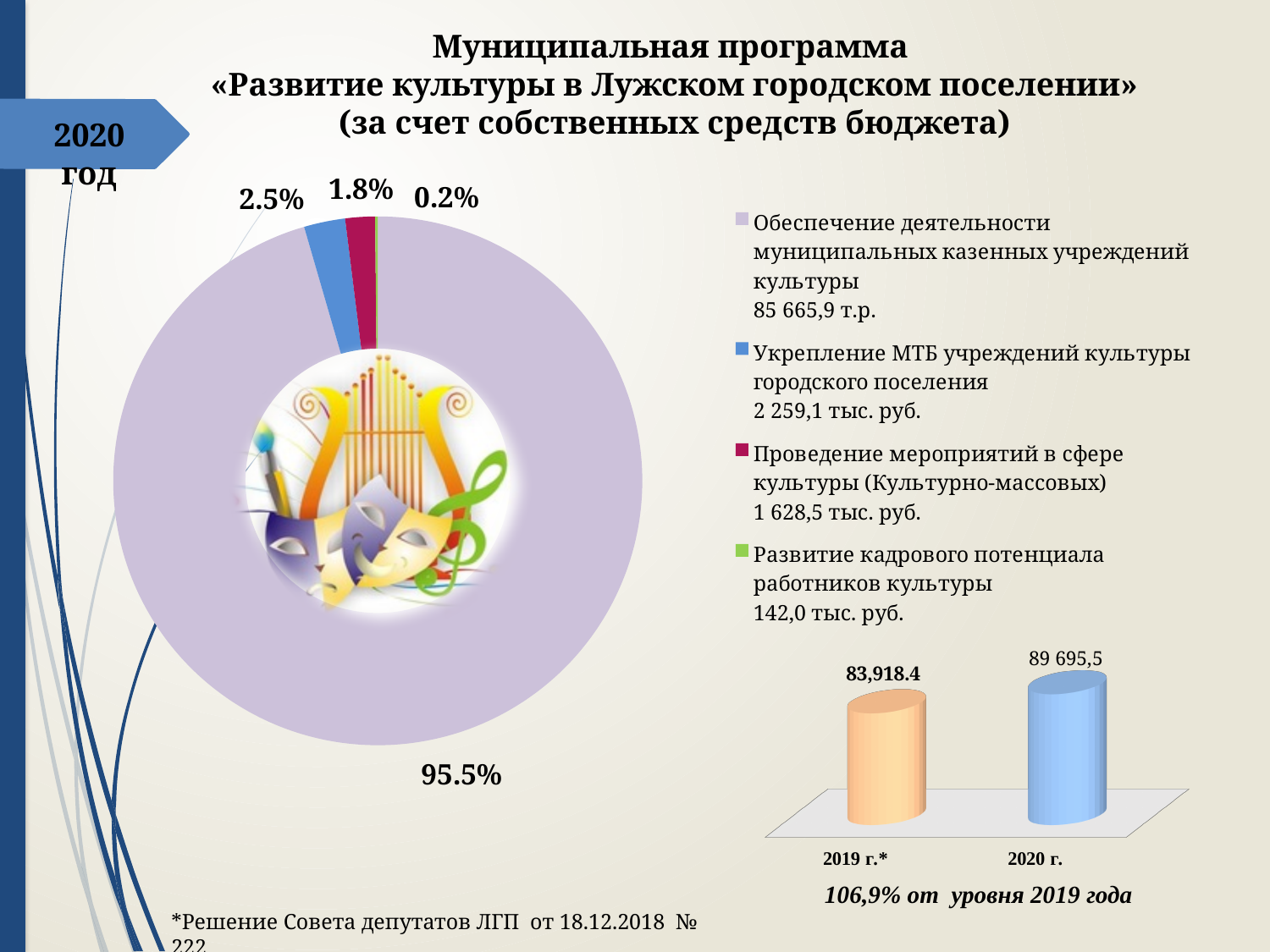
On the bar chart in the bottom right, what is the value for 2020 г.? 89 695,5 On the pie chart, what is the difference in percentage points between the 2.5% slice and the 1.8% slice? 0.7 On the pie chart, what share does the largest slice represent? 95.5% On the bar chart in the bottom right, which year has the larger value, 2019 г.* or 2020 г.? 2020 г. How many categories does the pie chart's legend list? 4 On the bar chart in the bottom right, what is the value for 2019 г.*? 83,918.4 What type of chart is shown in the bottom right of the slide? Bar chart On the pie chart, what percentage is shown for the blue slice (Укрепление МТБ учреждений культуры городского поселения)? 2.5% On the pie chart, which category has the smallest share? Развитие кадрового потенциала работников культуры On the pie chart, what percentage is shown for Проведение мероприятий в сфере культуры (Культурно-массовых)? 1.8% On the pie chart, which category has the largest share? Обеспечение деятельности муниципальных казенных учреждений культуры On the pie chart, what percentage is shown for Развитие кадрового потенциала работников культуры? 0.2%